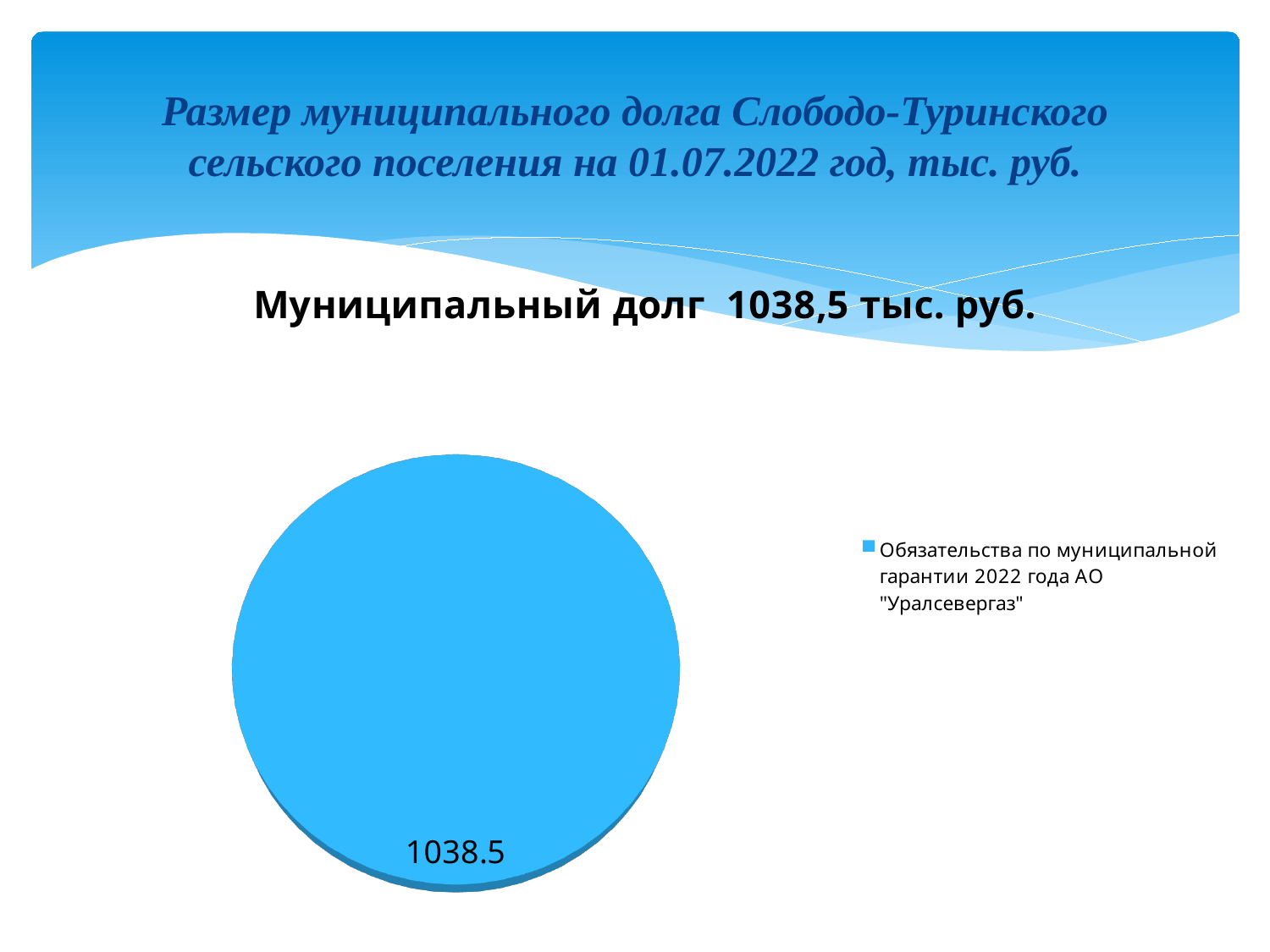
How many entries does the legend list? 1 What is the legend entry of the pie chart? Обязательства по муниципальной гарантии 2022 года АО "Уралсевергаз" How many slices does the pie chart have? 1 What kind of chart is shown on the slide? pie chart What colour is the pie slice? blue Is the value shown on the pie chart greater or less than 1000? greater What share of the pie does the slice for Обязательства по муниципальной гарантии 2022 года АО "Уралсевергаз" represent? 100% What value is printed on the pie slice? 1038.5 What is the value for Обязательства по муниципальной гарантии 2022 года АО "Уралсевергаз"? 1038.5